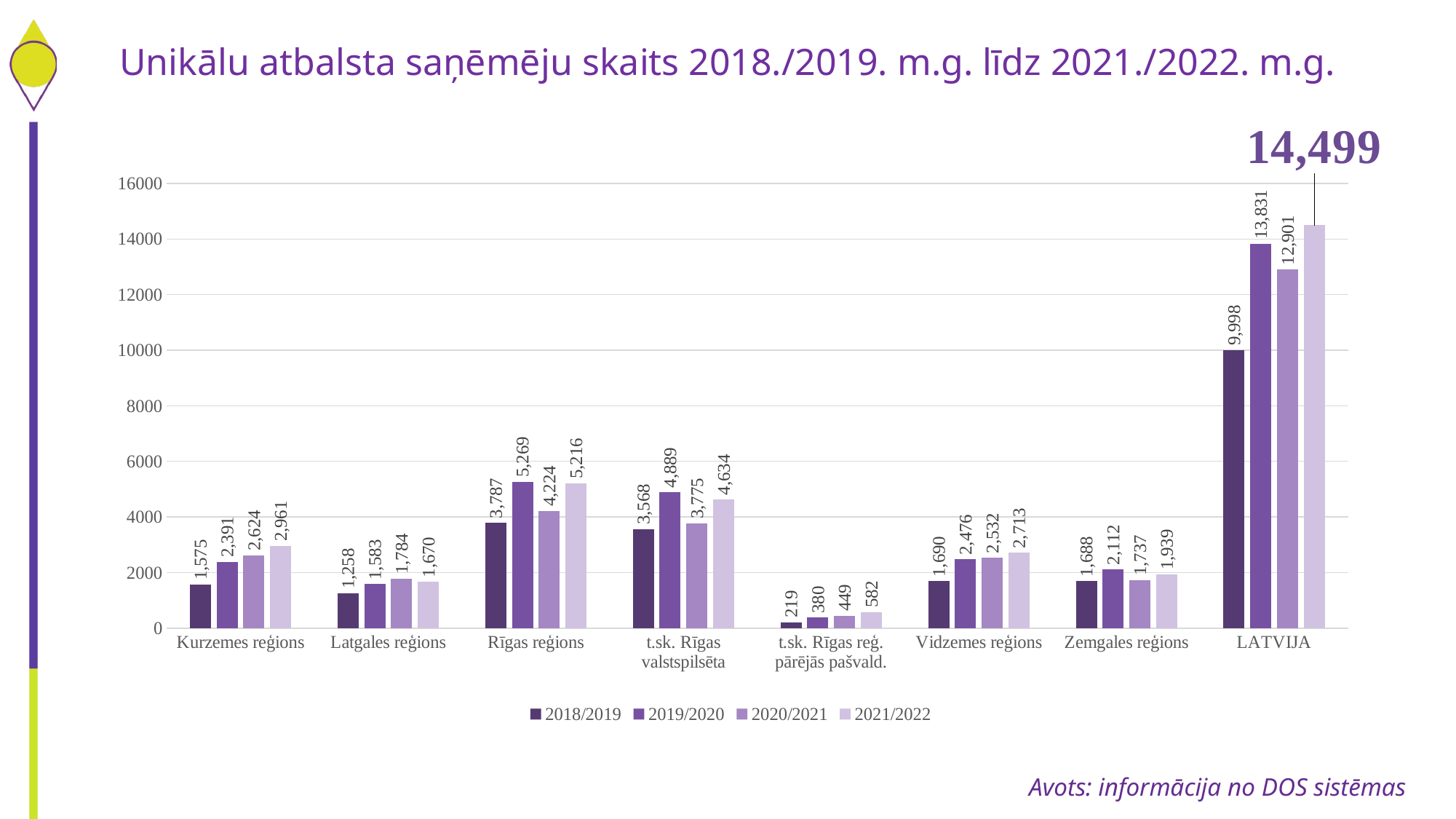
What is the value for Kurzemes reģions in the 2021/2022 series? 2,961 Which is larger for Zemgales reģions: the 2019/2020 value or the 2021/2022 value? 2,112 (2019/2020) What is the difference between the 2021/2022 and 2018/2019 values for Rīgas reģions? 1,429 What kind of chart is shown on the slide? Bar chart What is the title of the chart? Unikālu atbalsta saņēmēju skaits 2018./2019. m.g. līdz 2021./2022. m.g. Which category has the lowest value in the 2018/2019 series? t.sk. Rīgas reģ. pārējās pašvald. How many categories are shown on the x axis? 8 What is the value for LATVIJA in the 2018/2019 series? 9,998 Which category has the highest value in the 2019/2020 series? LATVIJA What is the value for t.sk. Rīgas reģ. pārējās pašvald. in the 2020/2021 series? 449 How many series does the legend list? 4 Is the 2020/2021 value for LATVIJA greater or less than 12000? greater